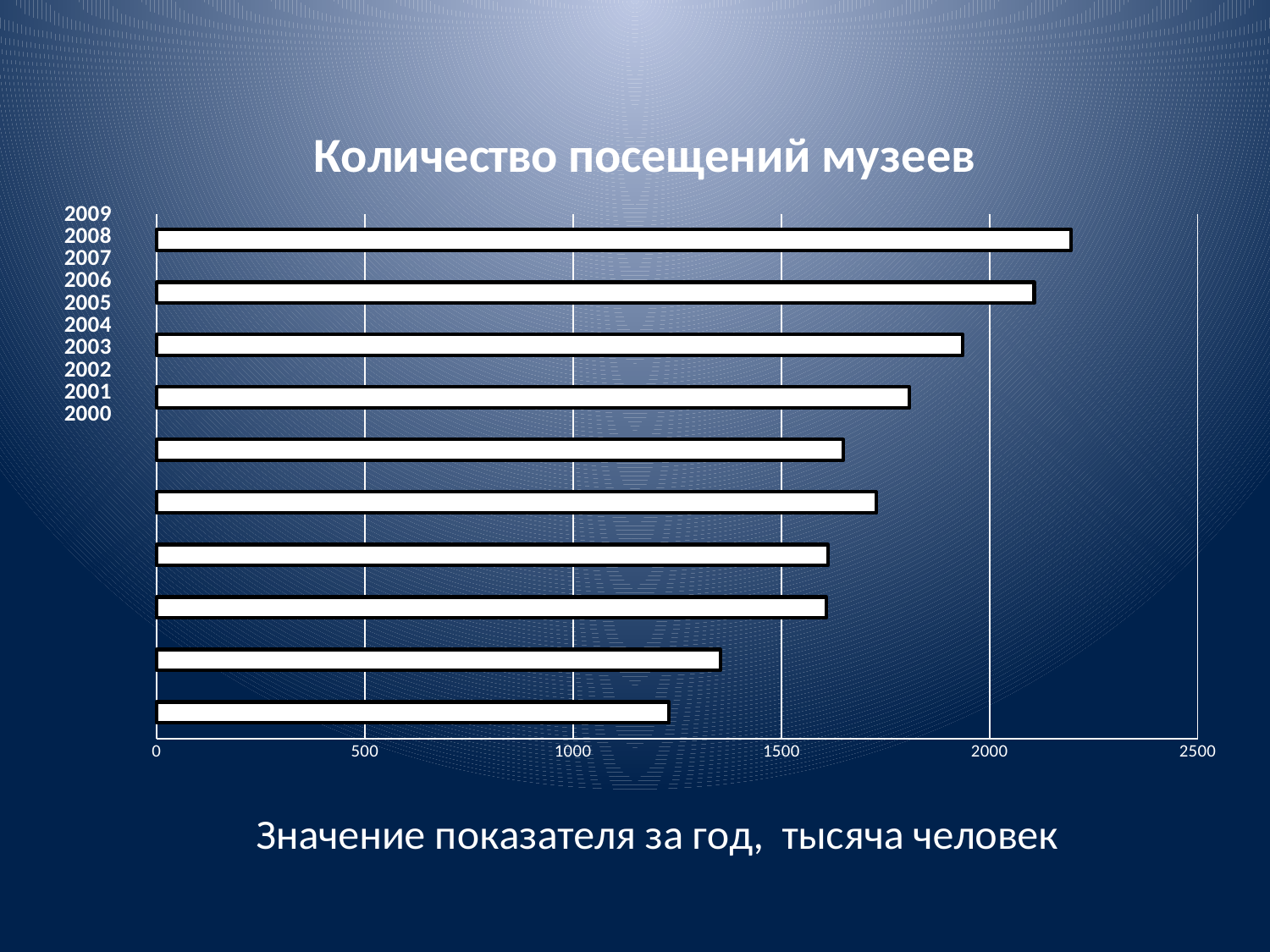
Is the value of the fourth bar from the top greater or less than 1500? greater Is the value of the third bar from the top greater or less than 2000? less What is the title of the chart? Количество посещений музеев What kind of chart is shown on the slide? bar chart Is the value of the topmost bar greater or less than 2000? greater How many bars are plotted in the chart? 10 Do the bar values generally increase or decrease going from the bottom of the chart to the top? increase What is the highest value shown on the horizontal axis of the chart? 2500 Which bar has the largest value: the topmost bar or the bottom bar? the topmost bar Which bar in the chart is the shortest? the bottom bar